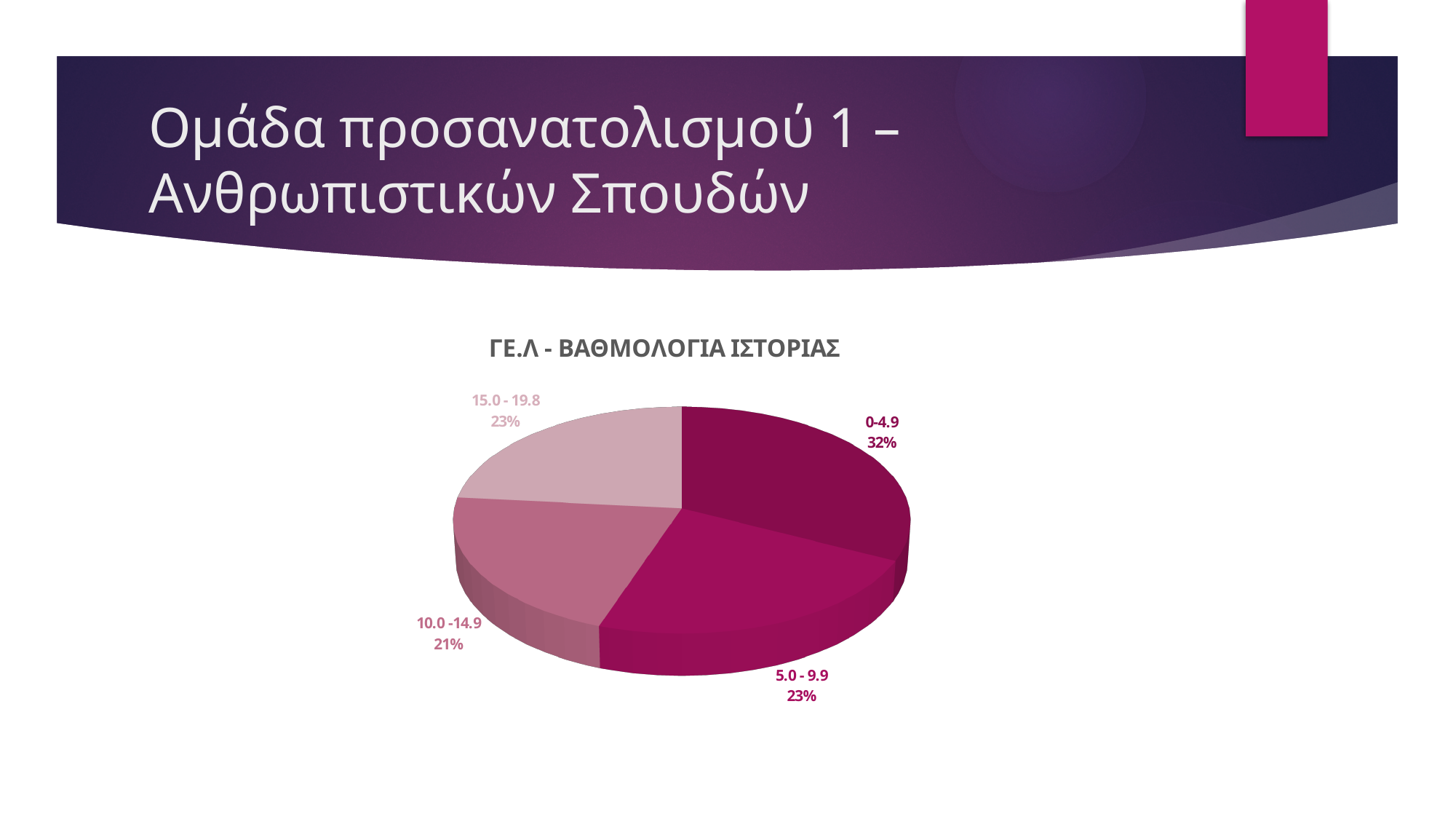
What kind of chart is shown on the slide? pie chart Which category has the smallest share of the pie? 10.0 -14.9 How many categories are shown in the pie chart? 4 Which is larger, the share for 0-4.9 or the share for 5.0 - 9.9? 0-4.9 What share of the pie does the 15.0 - 19.8 category have? 23% What is the difference in percentage points between the 0-4.9 share and the 10.0 -14.9 share? 11 What share of the pie does the 10.0 -14.9 category have? 21% Which category has the largest share of the pie? 0-4.9 Is the share for 0-4.9 greater or less than 30%? greater What share of the pie does the 0-4.9 category have? 32% What is the title of the chart? ΓΕ.Λ - ΒΑΘΜΟΛΟΓΙΑ ΙΣΤΟΡΙΑΣ